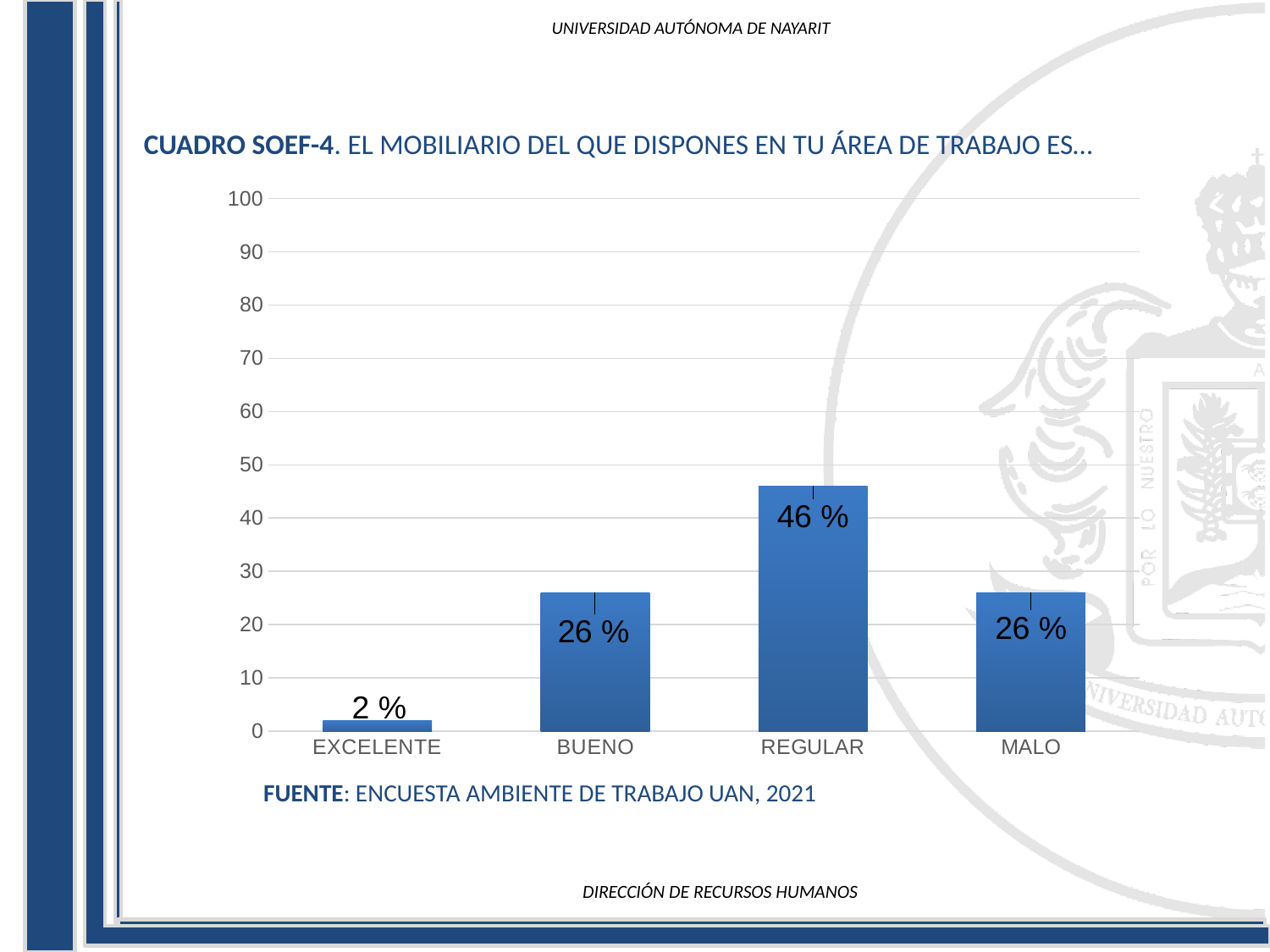
What is the value for EXCELENTE? 2 % Is the value for REGULAR greater or less than 50? less Which is larger, the value for BUENO or the value for EXCELENTE? BUENO What is the value for REGULAR? 46 % Which category has the lowest value? EXCELENTE Which category has the highest value? REGULAR What is the difference between the values for REGULAR and MALO? 20 % How many categories are shown on the x axis? 4 What is the value for BUENO? 26 % What is the title of the chart? CUADRO SOEF-4. EL MOBILIARIO DEL QUE DISPONES EN TU ÁREA DE TRABAJO ES… What kind of chart is shown on the slide? bar chart What is the source cited below the chart? ENCUESTA AMBIENTE DE TRABAJO UAN, 2021